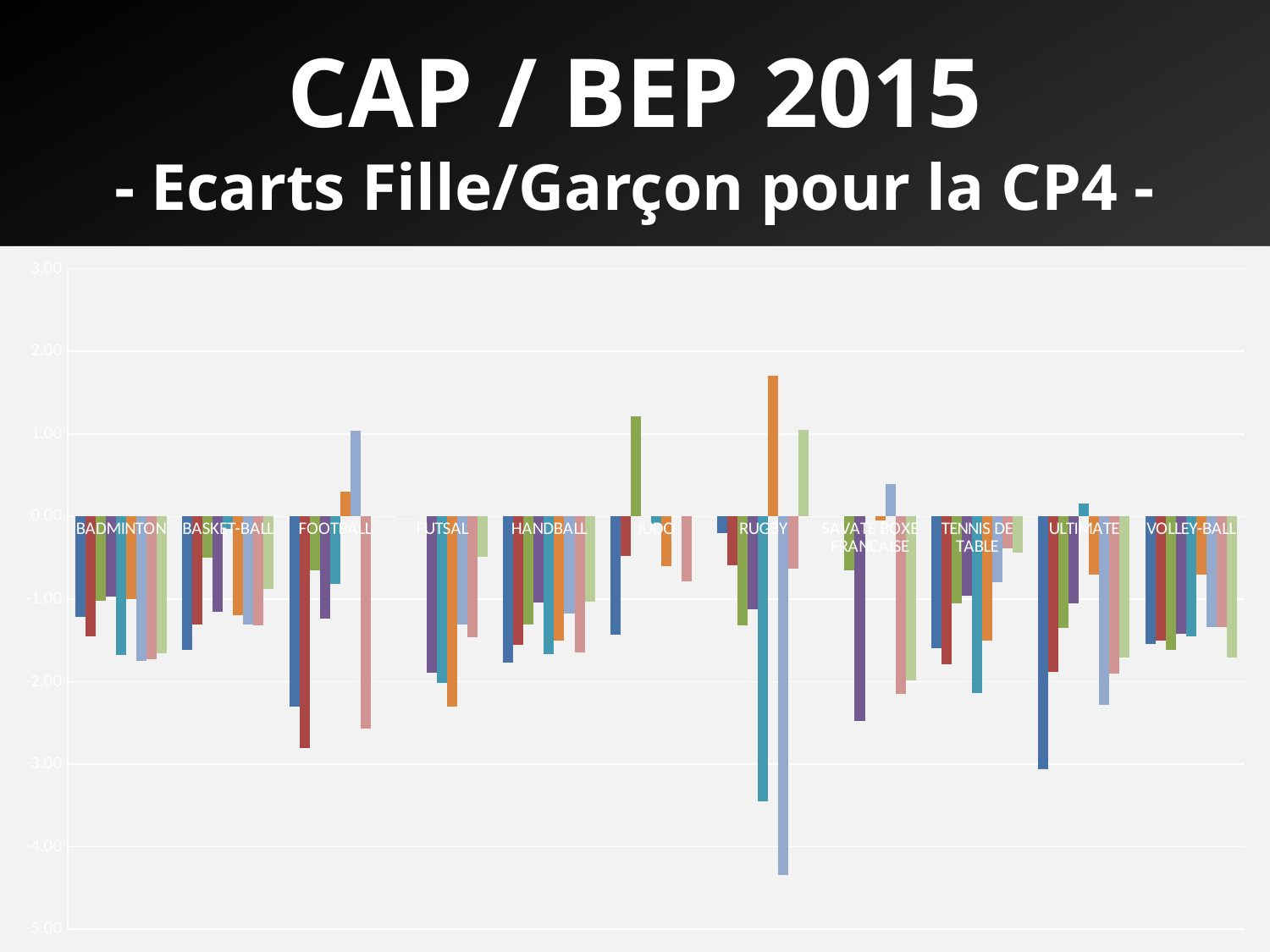
What is the maximum value shown on the vertical axis of the chart? 3.00 Is the highest bar for JUDO greater or less than 1.00? greater What kind of chart is shown on the slide? bar chart Which category contains the lowest bar on the chart? RUGBY Is the lowest bar for RUGBY greater or less than -4.00? less Is the lowest bar for FOOTBALL greater or less than -2.00? less Which category contains the highest bar on the chart? RUGBY How many sport categories are shown along the x axis of the chart? 11 What is the subtitle of the slide above the chart? - Ecarts Fille/Garçon pour la CP4 -